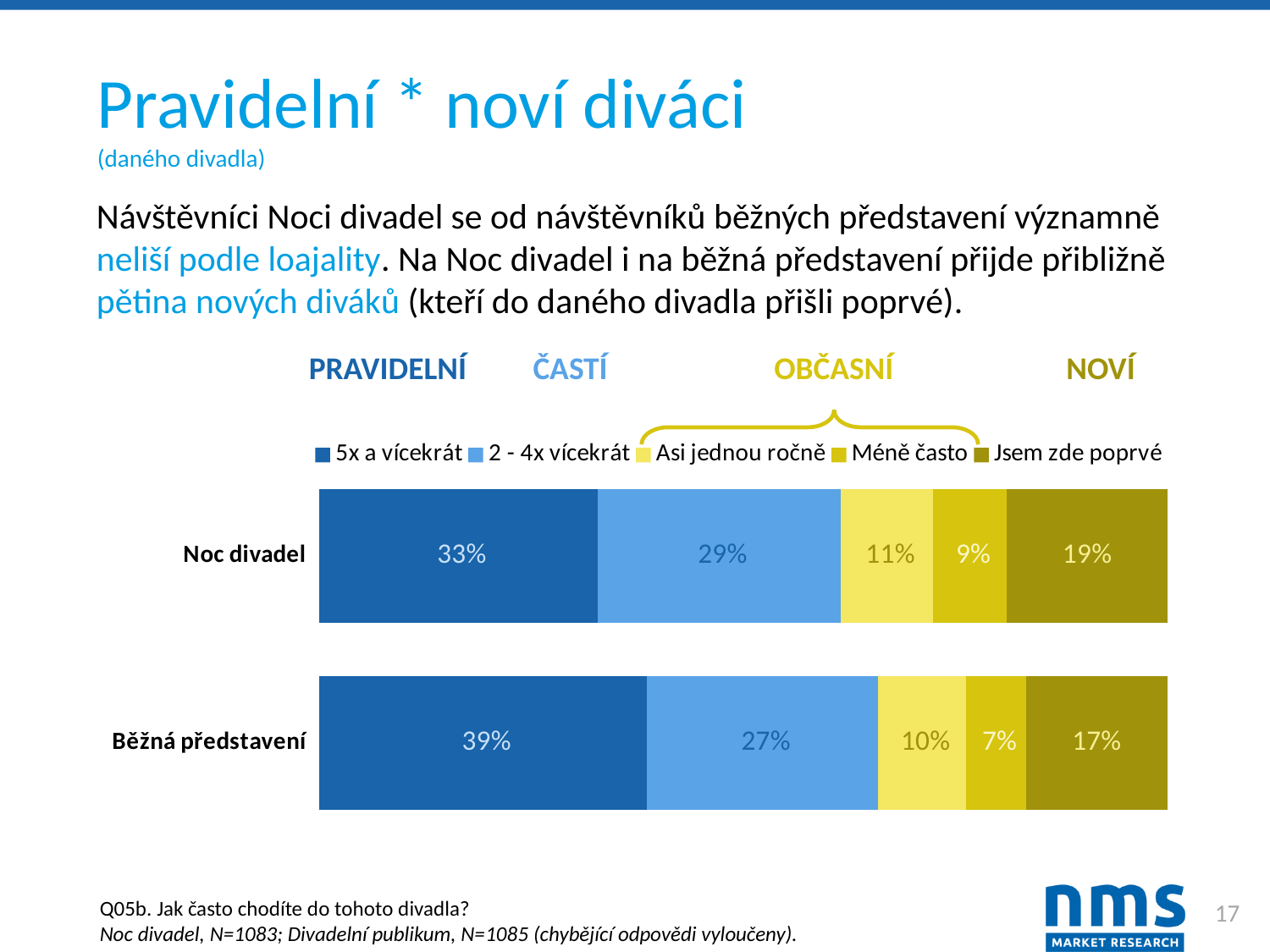
Which series has the largest value in the Noc divadel bar? 5x a vícekrát What kind of chart is shown on the slide? stacked bar chart How many categories (bars) are plotted in the chart? 2 What is the value of '5x a vícekrát' for Běžná představení? 39% What is the value of '5x a vícekrát' for Noc divadel? 33% What is the value of 'Jsem zde poprvé' for Noc divadel? 19% Which category has the larger value for '2 - 4x vícekrát', Noc divadel or Běžná představení? Noc divadel What is the difference between the '5x a vícekrát' values for Běžná představení and Noc divadel? 6% What is the value of 'Méně často' for Běžná představení? 7% Which series has the smallest value in the Běžná představení bar? Méně často How many series does the legend list? 5 What is the value of 'Asi jednou ročně' for Noc divadel? 11%